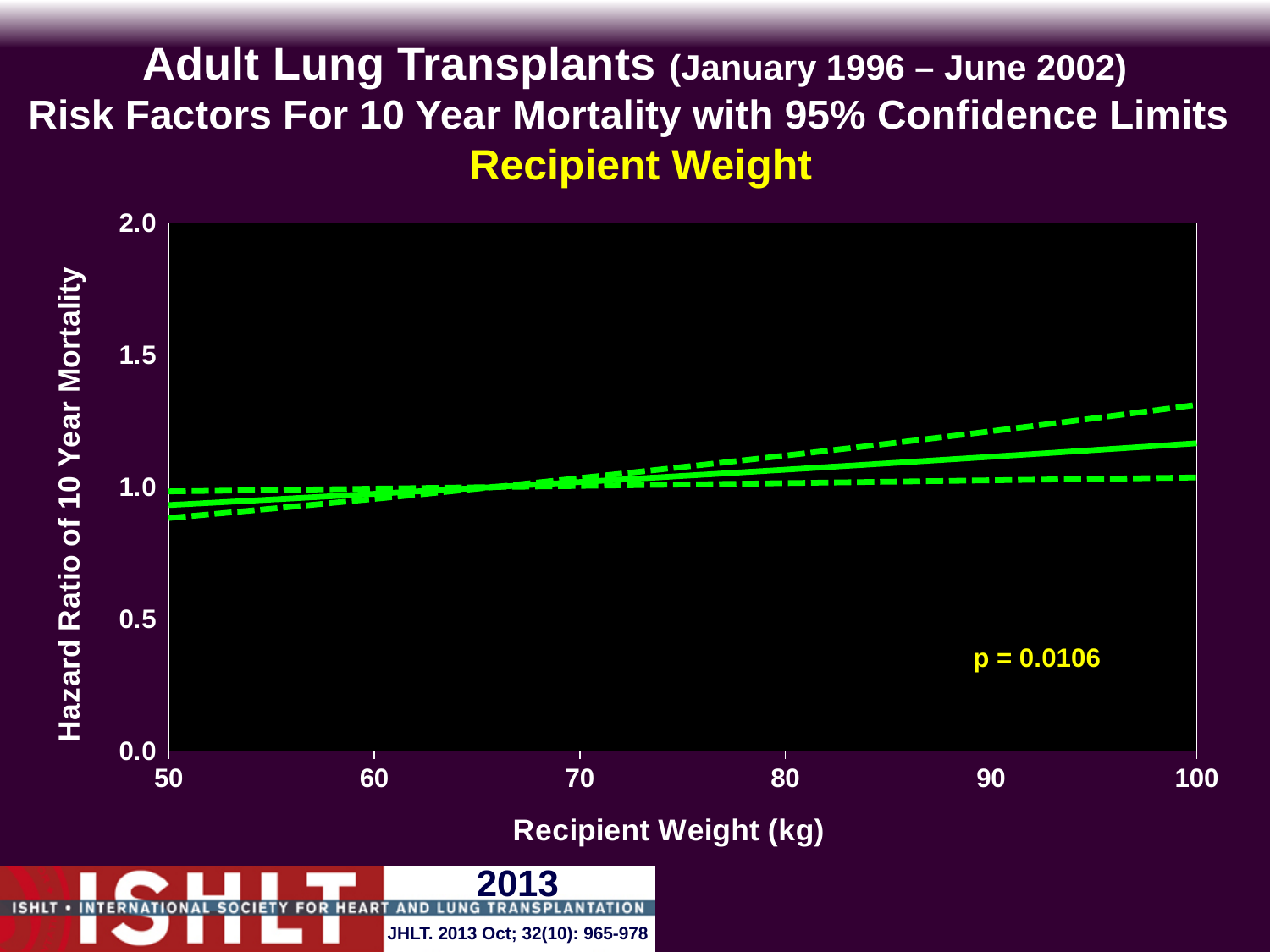
Is the upper 95% confidence limit (upper dashed line) at 100 kg greater or less than 1.5? less Is the hazard ratio (solid line) at a recipient weight of 100 kg greater or less than 1.0? greater Does the hazard ratio (solid line) rise or fall as recipient weight increases from 50 to 100 kg? rise Is the hazard ratio (solid line) higher at a recipient weight of 50 kg or at 100 kg? 100 kg Is the hazard ratio (solid line) at a recipient weight of 50 kg greater or less than 1.0? less What is the label of the x axis? Recipient Weight (kg) What kind of chart is shown on the slide? line chart What p-value is shown on the chart? p = 0.0106 How many lines are plotted on the chart? 3